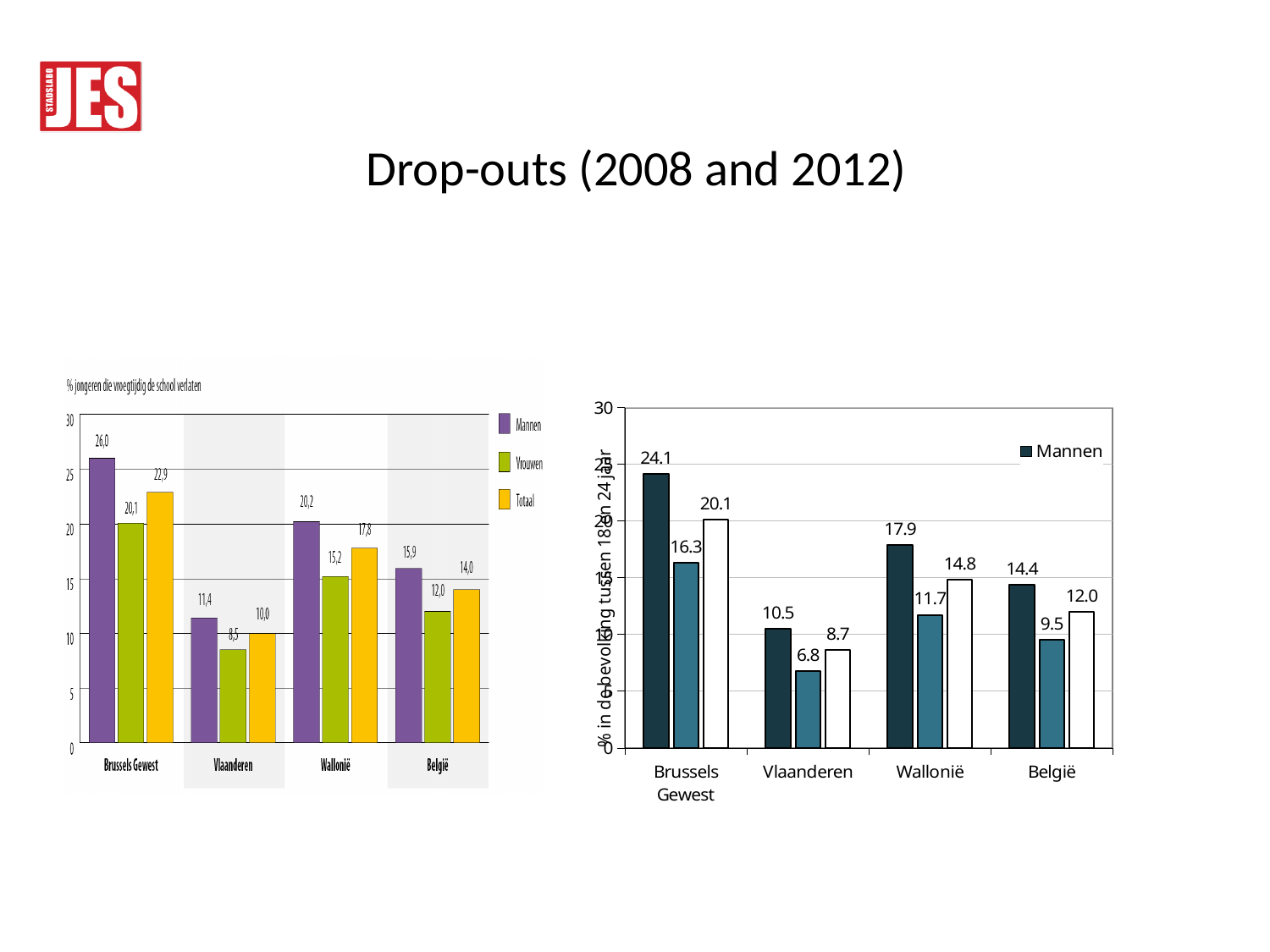
In the left chart, which region has the lowest Vrouwen value? Vlaanderen In the right chart, which region has the highest Mannen value? Brussels Gewest In the left chart, what is the value for Mannen in Brussels Gewest? 26,0 In the right chart, what is the value for Mannen in Wallonië? 17.9 In the left chart, what is the Totaal value for Wallonië? 17,8 How many regions are shown on the x axis of the right chart? 4 In the right chart, is the Mannen value for België larger or smaller than the Mannen value for Wallonië? smaller In the right chart, what is the difference between the Mannen values for Brussels Gewest and Vlaanderen? 13.6 In the left chart, what is the difference between the Mannen and Vrouwen values for België? 3,9 What type of chart is the right chart? bar chart In the right chart, what is the value of the white bar for Vlaanderen? 8.7 How many series does the legend of the left chart list? 3